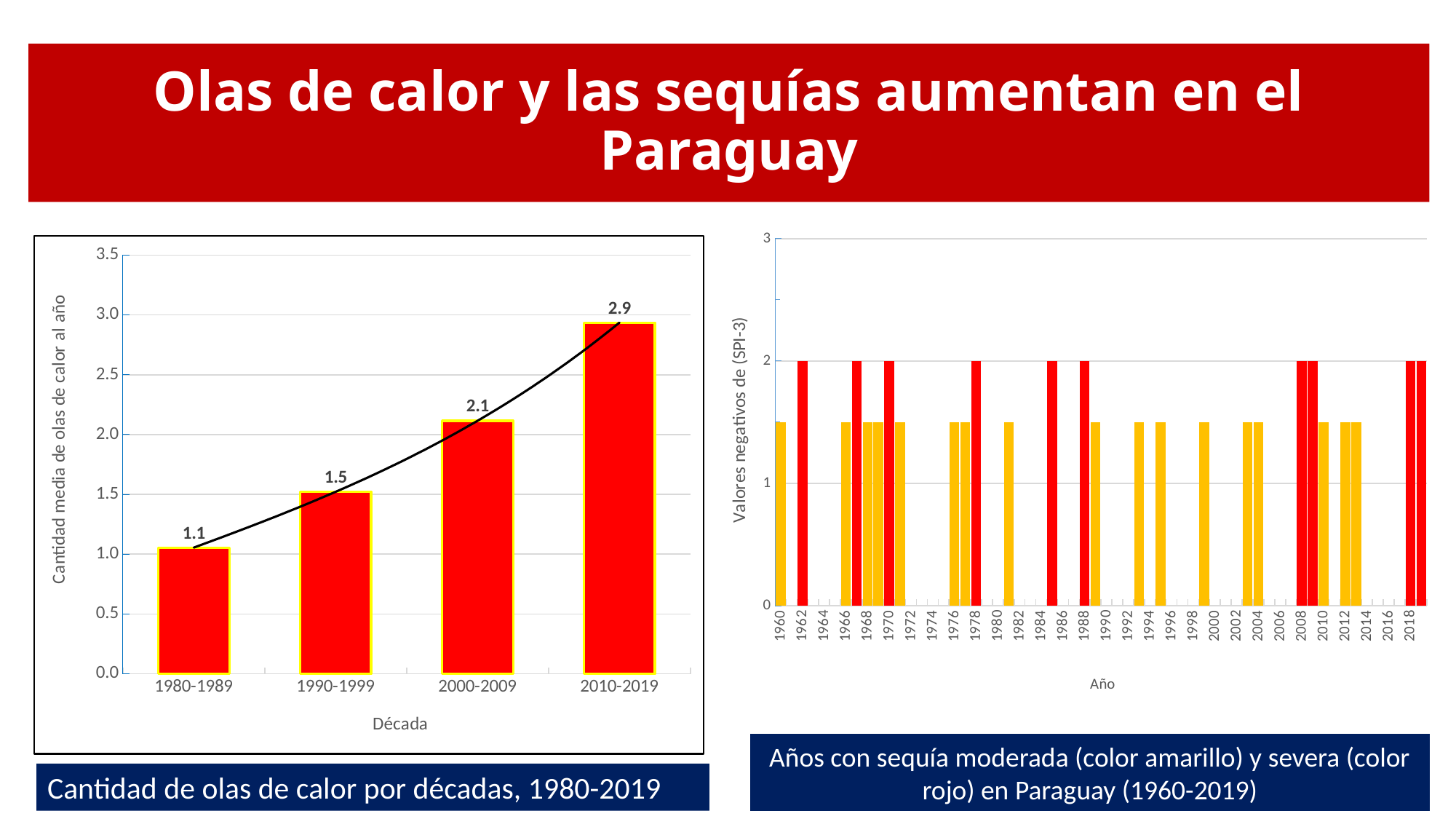
What kind of chart is the left chart (Cantidad de olas de calor por décadas)? bar chart In the left chart (Cantidad de olas de calor por décadas), which decade has the lowest value? 1980-1989 In the left chart (Cantidad de olas de calor por décadas), how many decades are shown on the x axis? 4 In the left chart (Cantidad de olas de calor por décadas), what is the value for 1990-1999? 1.5 In the left chart (Cantidad de olas de calor por décadas), which is larger, the value for 1990-1999 or the value for 2000-2009? 2000-2009 In the left chart (Cantidad de olas de calor por décadas), what is the value for 1980-1989? 1.1 In the right chart (Años con sequía moderada y severa en Paraguay), what is the title of the y axis? Valores negativos de (SPI-3) In the left chart (Cantidad de olas de calor por décadas), what is the value for 2010-2019? 2.9 In the left chart (Cantidad de olas de calor por décadas), do the values rise or fall from 1980-1989 to 2010-2019? rise In the left chart (Cantidad de olas de calor por décadas), what is the difference between the values for 2010-2019 and 2000-2009? 0.8 In the right chart (Años con sequía moderada y severa en Paraguay), is the value for 1962 greater or less than 1? greater In the left chart (Cantidad de olas de calor por décadas), which decade has the highest value? 2010-2019